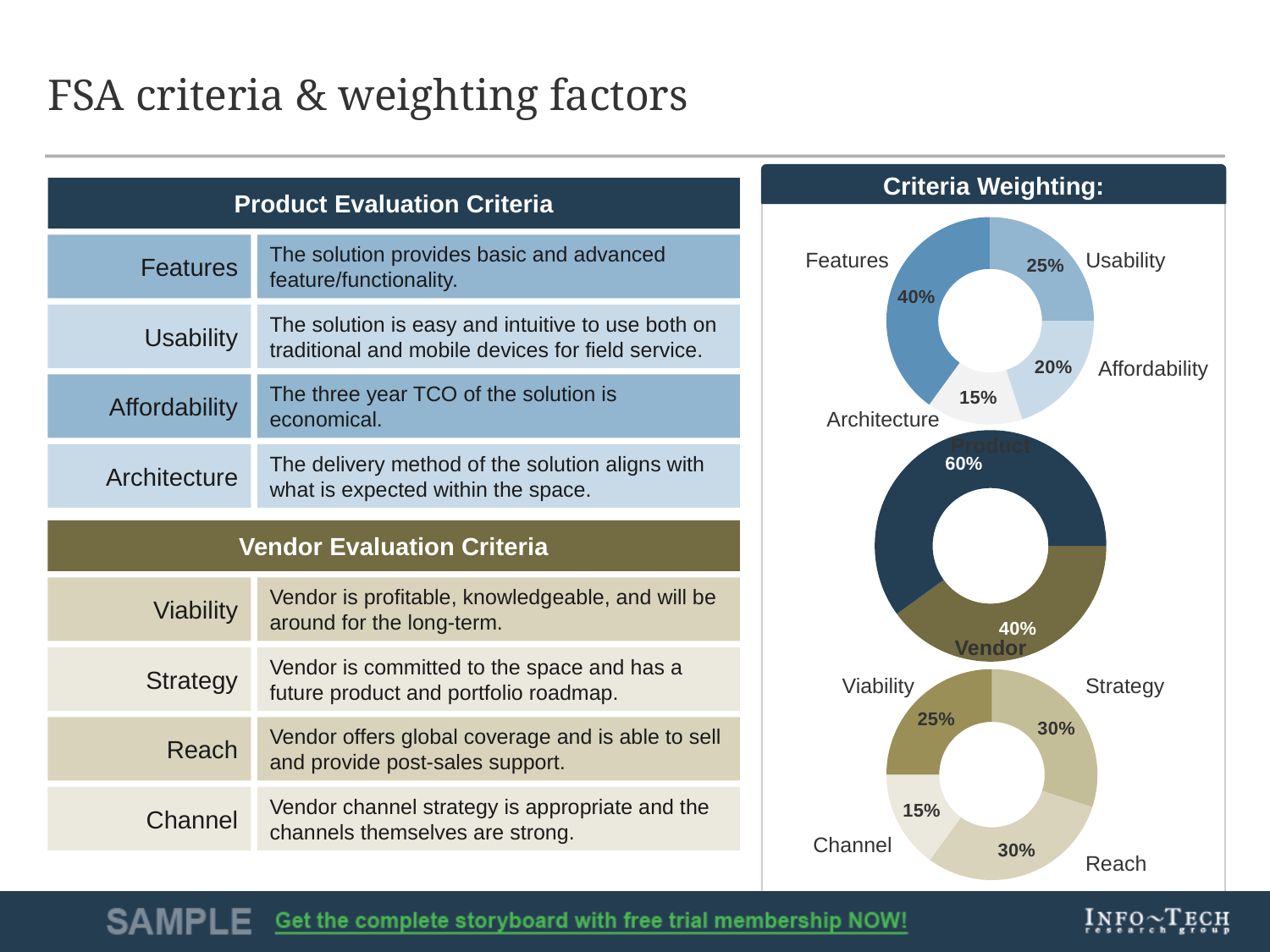
In the top donut chart under Criteria Weighting, what is the difference between the Features and Usability weightings? 15% In the top donut chart under Criteria Weighting, what is the weighting for Affordability? 20% In the bottom donut chart under Criteria Weighting, what is the weighting for Viability? 25% In the top donut chart under Criteria Weighting, what is the weighting for Features? 40% In the bottom donut chart under Criteria Weighting, how many criteria are shown? 4 In the top donut chart under Criteria Weighting, which criterion has the highest weighting? Features In the top donut chart under Criteria Weighting, which criterion has the lowest weighting? Architecture In the bottom donut chart under Criteria Weighting, what is the weighting for Channel? 15% How many donut charts are shown under the Criteria Weighting heading? 3 What kind of chart is used for the Criteria Weighting visuals? Donut (pie) chart In the middle donut chart under Criteria Weighting, what is the weighting for Product? 60% In the middle donut chart under Criteria Weighting, which is larger, Product or Vendor? Product